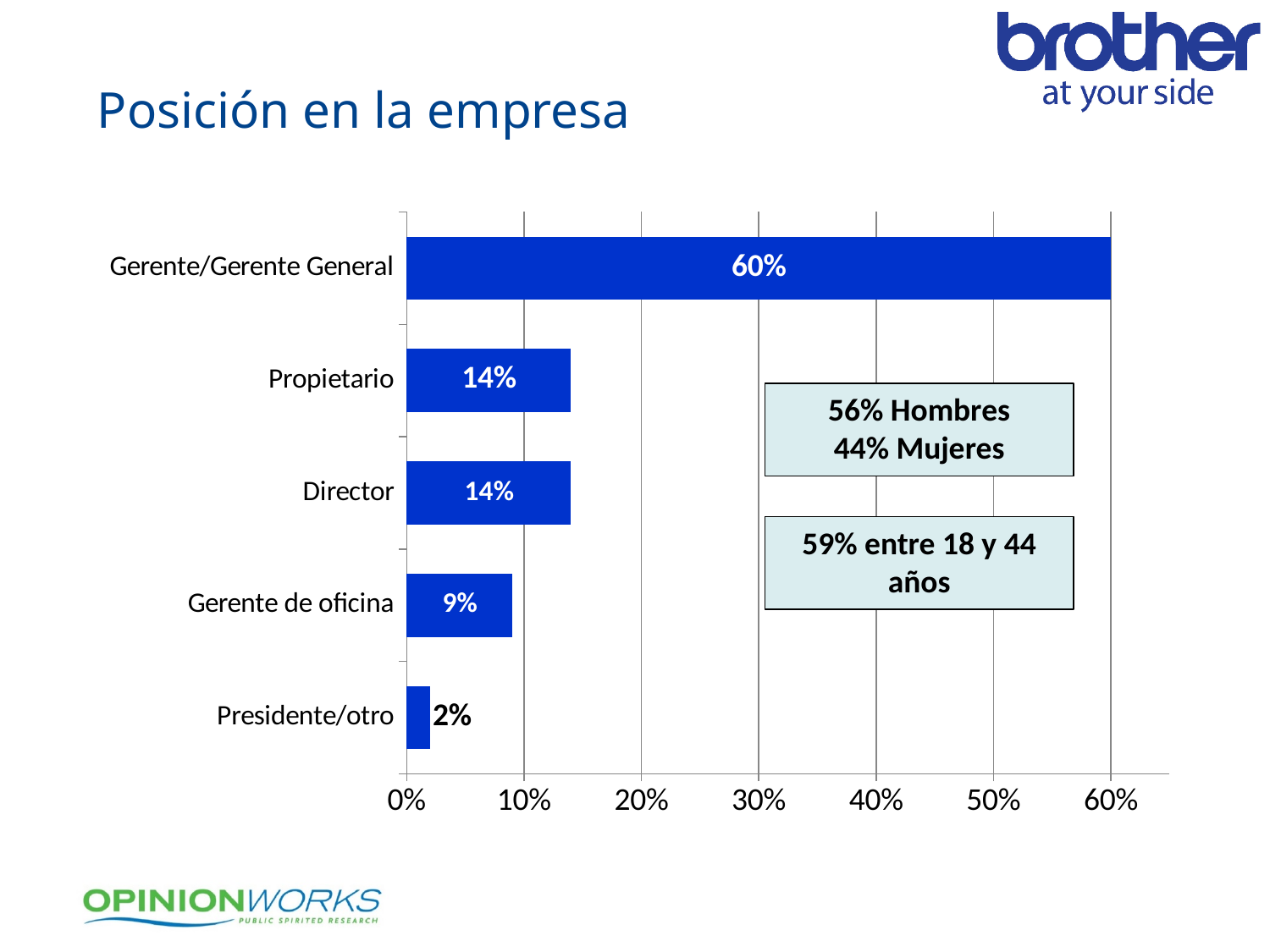
Which category has the highest value? Gerente/Gerente General Which is larger, the value for Director or the value for Gerente de oficina? Director What is the value for Presidente/otro? 2% How many categories are shown in the chart? 5 Is the value for Gerente/Gerente General greater or less than 50%? greater What is the value for Gerente de oficina? 9% Which category has the lowest value? Presidente/otro What is the value for Propietario? 14% What is the difference between the values for Gerente/Gerente General and Propietario? 46% What is the value for Gerente/Gerente General? 60% What kind of chart is shown on the slide? bar chart What is the difference between the values for Gerente de oficina and Presidente/otro? 7%